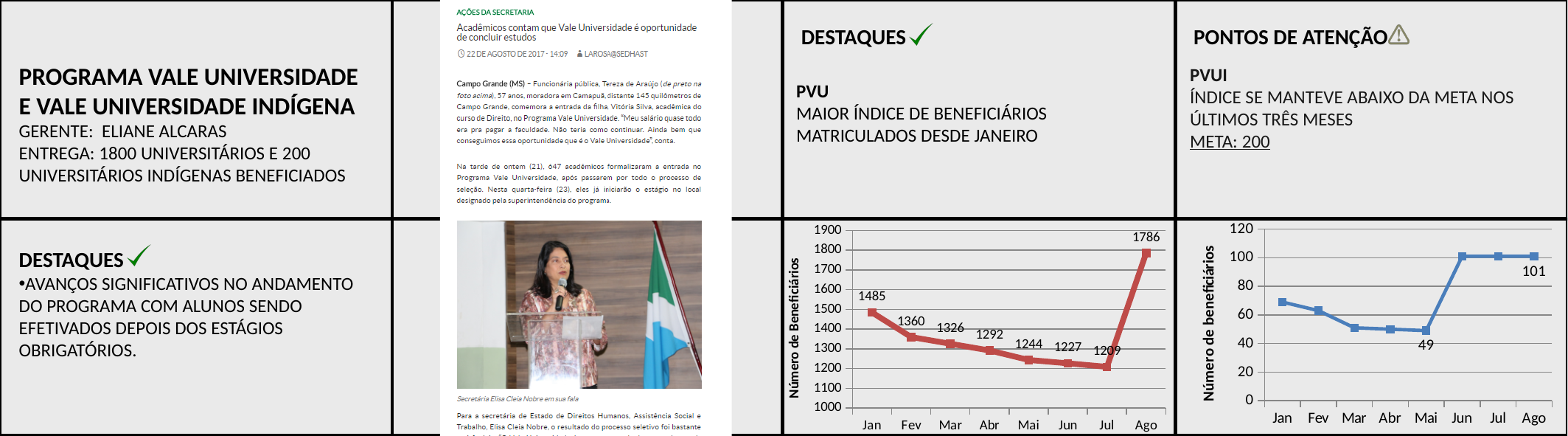
On the left chart (red line), do the values rise or fall from Jan to Jul? fall On the left chart (red line), what is the value for Ago? 1786 On the right chart (blue line), is the value for Jan greater or less than 60? greater On the left chart (red line), what is the value for Jan? 1485 On the left chart (red line), which month has the highest value? Ago On the left chart (red line), which is larger, the value for Fev or the value for Mai? Fev On the right chart (blue line), what is the value for Ago? 101 On the right chart (blue line), what is the value for Mai? 49 On the left chart (red line), what is the difference between the values for Ago and Jul? 577 On the left chart (red line), which month has the lowest value? Jul On the left chart (red line), how many months are plotted? 8 What type of chart is the right chart (blue line)? line chart